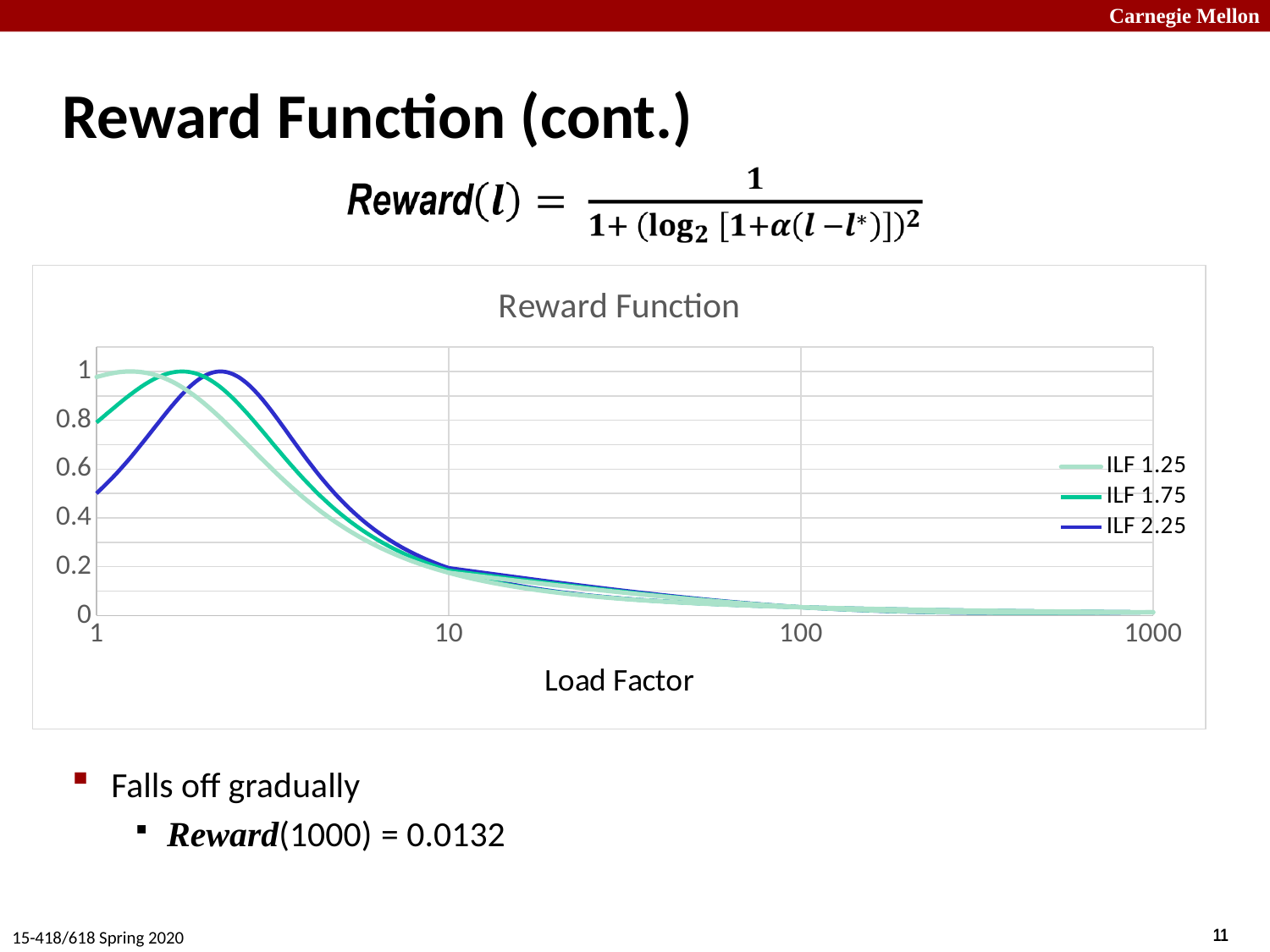
What is the label of the x axis of the chart? Load Factor Between a load factor of 10 and a load factor of 1000, do the values of the series rise or fall? fall Is the value for ILF 2.25 at a load factor of 1 greater or less than 0.4? greater Which series has the highest value at a load factor of 1? ILF 1.25 At a load factor of 1, which is larger: the value for ILF 1.25 or the value for ILF 2.25? ILF 1.25 What kind of chart is shown on the slide? line chart Is the value for ILF 1.75 at a load factor of 1 greater or less than 0.6? greater Is the value for ILF 1.25 at a load factor of 100 greater or less than 0.2? less Which series has the lowest value at a load factor of 1? ILF 2.25 How many series does the chart's legend list? 3 What is the title of the chart? Reward Function